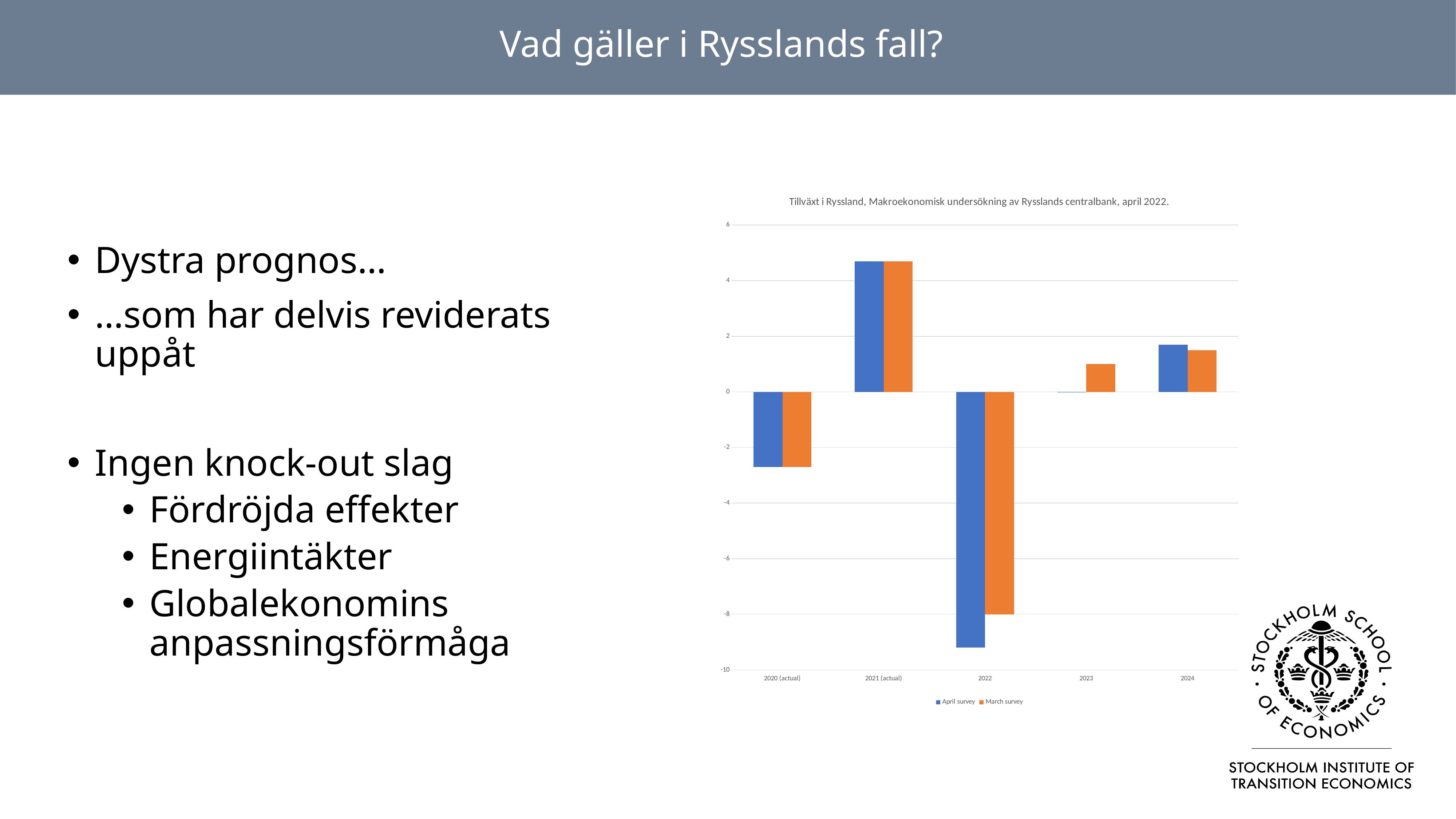
What is the title of the chart? Tillväxt i Ryssland, Makroekonomisk undersökning av Rysslands centralbank, april 2022. What kind of chart is shown on the slide? bar chart For 2023, which series shows the larger value, April survey or March survey? March survey Is the March survey value for 2021 (actual) greater or less than 4? greater How many series does the chart's legend list? 2 Is the April survey value for 2020 (actual) greater or less than -2? less What are the two series named in the chart's legend? April survey and March survey Is the April survey value for 2022 greater or less than -8? less Which category has the lowest April survey value? 2022 For 2022, which series shows the larger value, April survey or March survey? March survey How many categories are shown on the x axis of the chart? 5